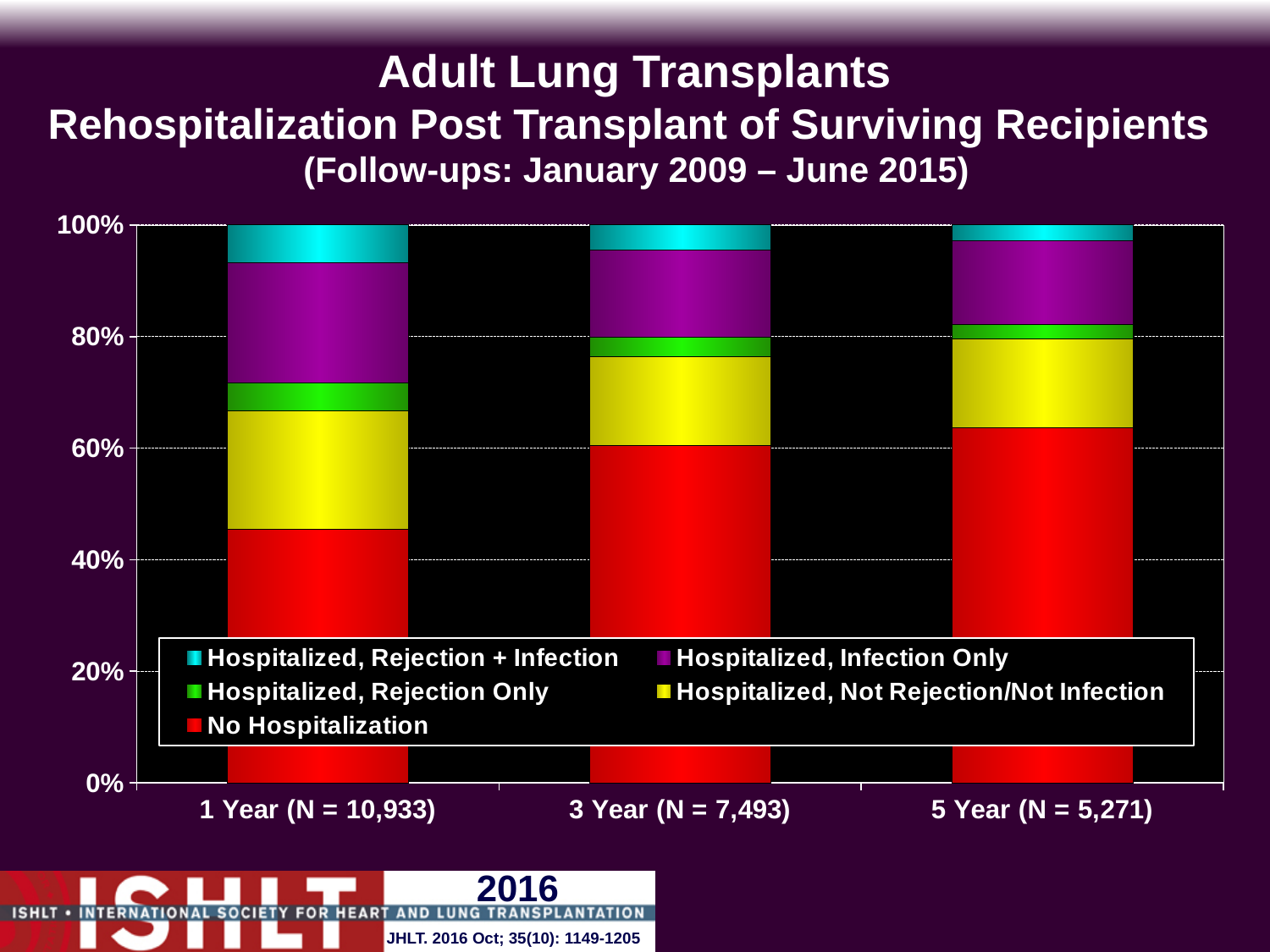
Is the No Hospitalization share for 5 Year greater or less than 60%? greater Which category has the largest Hospitalized, Rejection + Infection segment? 1 Year (N = 10,933) How many series does the legend list? 5 What is the N shown for the 5 Year category? 5,271 Which legend entry is shown in red? No Hospitalization Which is larger, the Hospitalized, Infection Only segment for 1 Year or for 5 Year? 1 Year What kind of chart is shown on the slide? stacked bar chart Does the No Hospitalization share rise or fall from 1 Year to 5 Year? rise What is the N shown for the 3 Year category? 7,493 How many time-point categories are plotted along the x axis? 3 What does each stacked bar total? 100% Is the No Hospitalization share for 1 Year greater or less than 40%? greater